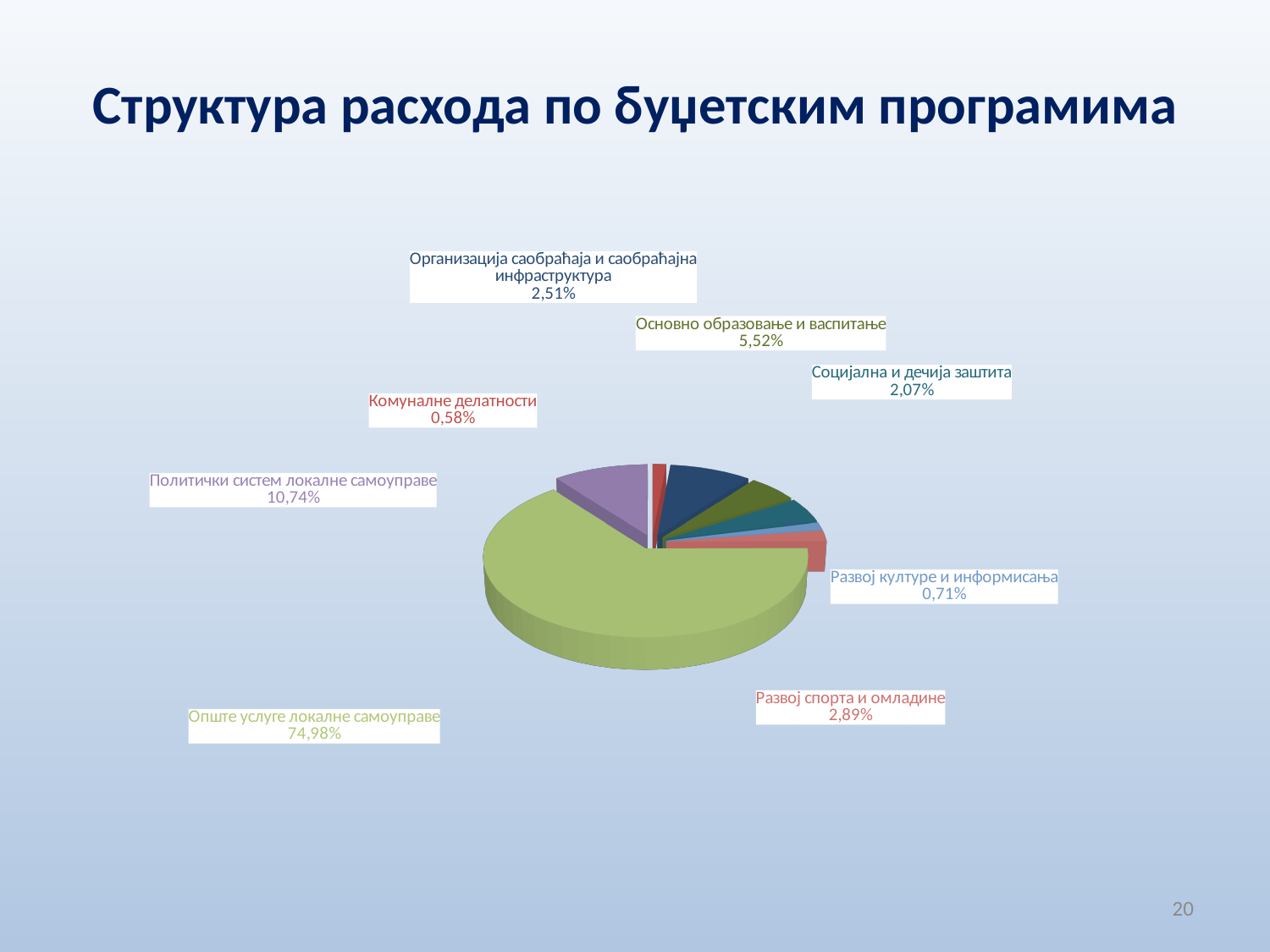
What is the value shown for Развој културе и информисања? 0,71% What kind of chart is shown on the slide? Pie chart How many categories (slices) does the pie chart show? 8 What is the title of the slide? Структура расхода по буџетским програмима What is the value shown for Социјална и дечија заштита? 2,07% What is the difference between the shares of Политички систем локалне самоуправе and Основно образовање и васпитање? 5,22% What share of the pie does Опште услуге локалне самоуправе have? 74,98% What is the value shown for Основно образовање и васпитање? 5,52% What is the value shown for Политички систем локалне самоуправе? 10,74% Which category has the largest share of the pie? Опште услуге локалне самоуправе Which category has the smallest share of the pie? Комуналне делатности